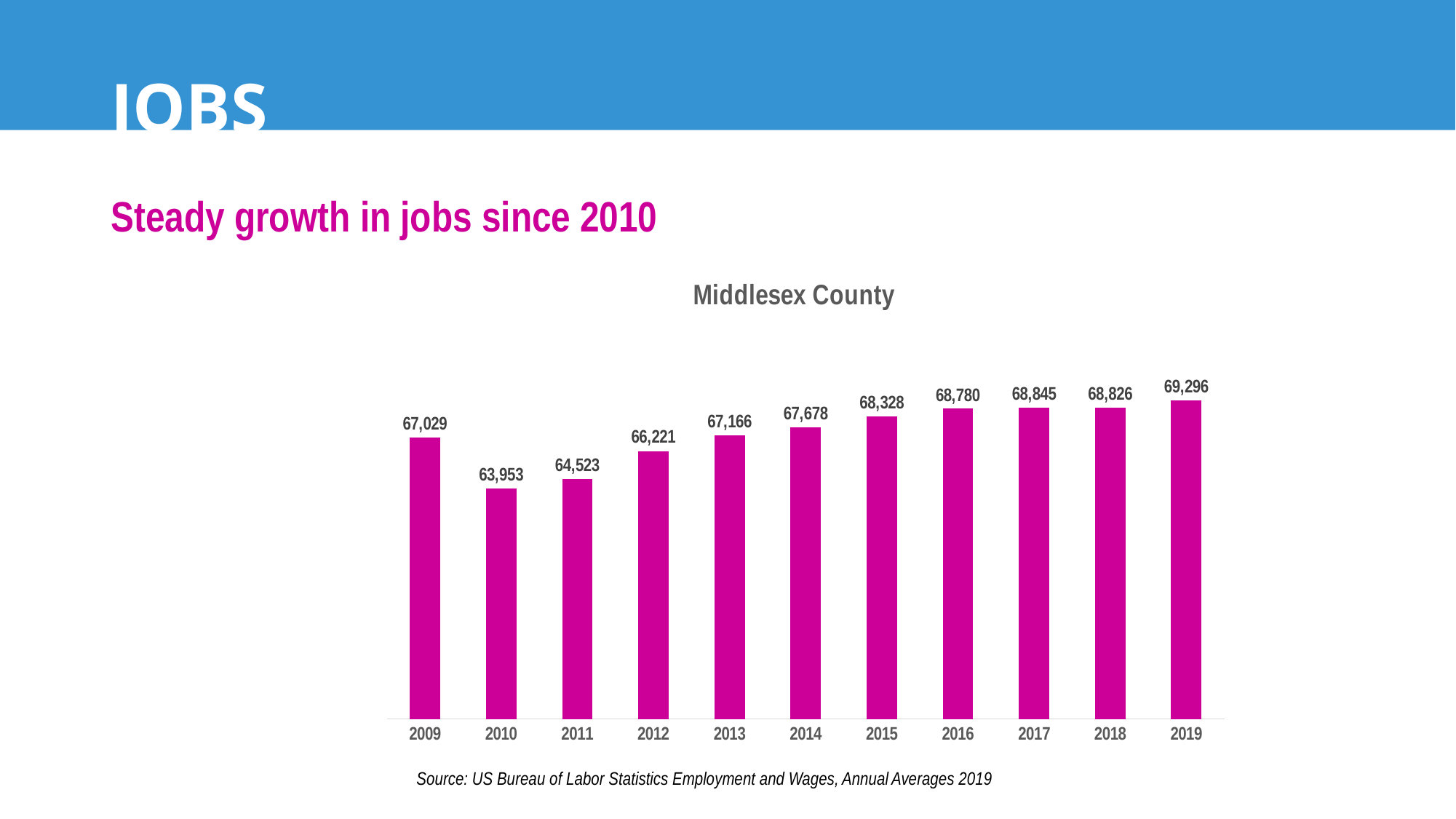
Which year has the highest value? 2019 Do the values generally rise or fall from 2010 to 2019? Rise What is the value for 2015? 68,328 What is the difference between the values for 2019 and 2010? 5,343 What is the value for 2010? 63,953 What is the value for 2019? 69,296 What is the title of the chart? Middlesex County Which year has the lowest value? 2010 How many years are plotted on the chart? 11 Which is larger, the value for 2009 or the value for 2011? 2009 What is the difference between the values for 2012 and 2011? 1,698 What kind of chart is shown on the slide? Bar chart